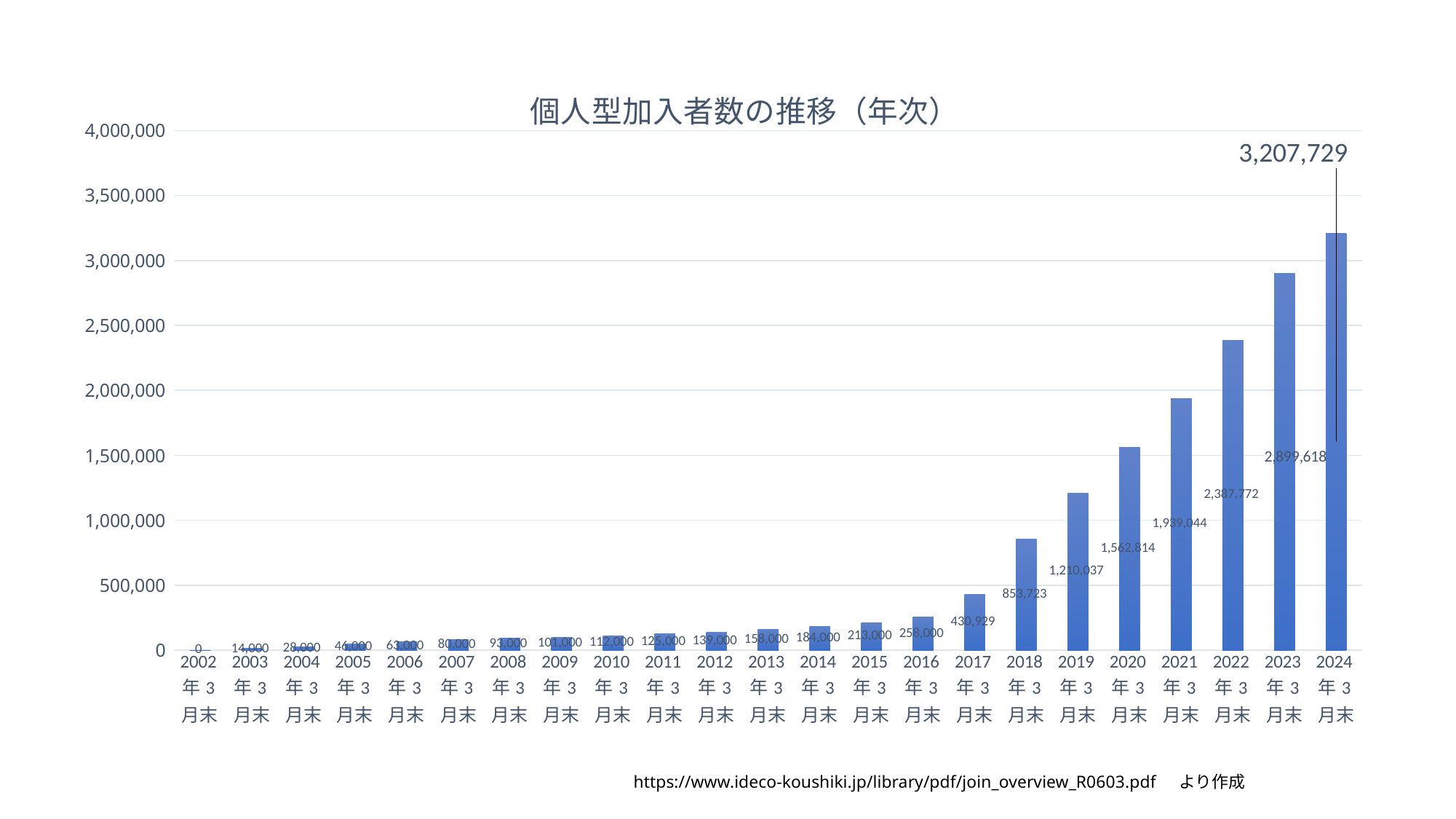
What is the value for 2017年3月末? 430,929 What type of chart is shown on the slide? bar chart What is the value for 2024年3月末? 3,207,729 Do the values rise or fall from 2002年3月末 to 2024年3月末? rise Which year has the lowest value? 2002年3月末 Which is larger, the value for 2019年3月末 or 2018年3月末? 2019年3月末 What is the title of the chart? 個人型加入者数の推移（年次） What is the value for 2020年3月末? 1,562,814 What is the difference between the values for 2024年3月末 and 2023年3月末? 308,111 What is the value for 2023年3月末? 2,899,618 Which year has the highest value? 2024年3月末 How many years (categories) are shown on the x axis? 23